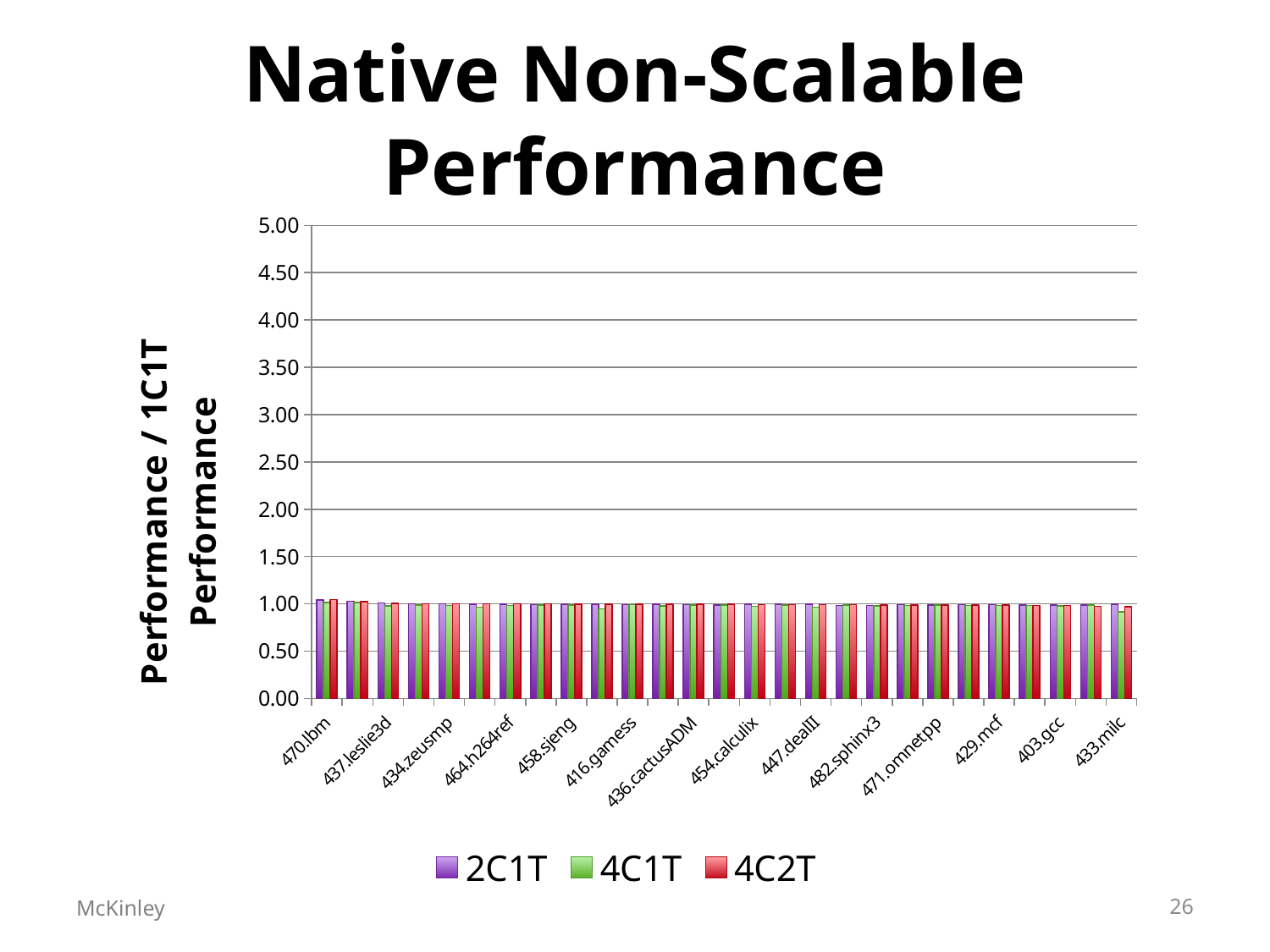
What is the highest value shown on the y axis? 5.00 Is the 2C1T value for 433.milc greater or less than 1.50? less How many benchmark categories are shown on the x axis? 27 Is the 4C1T value for 429.mcf greater or less than 0.50? greater What kind of chart is shown on the slide? bar chart What are the series names listed in the legend? 2C1T, 4C1T, 4C2T How many series does the legend list? 3 What is the title of the chart? Native Non-Scalable Performance